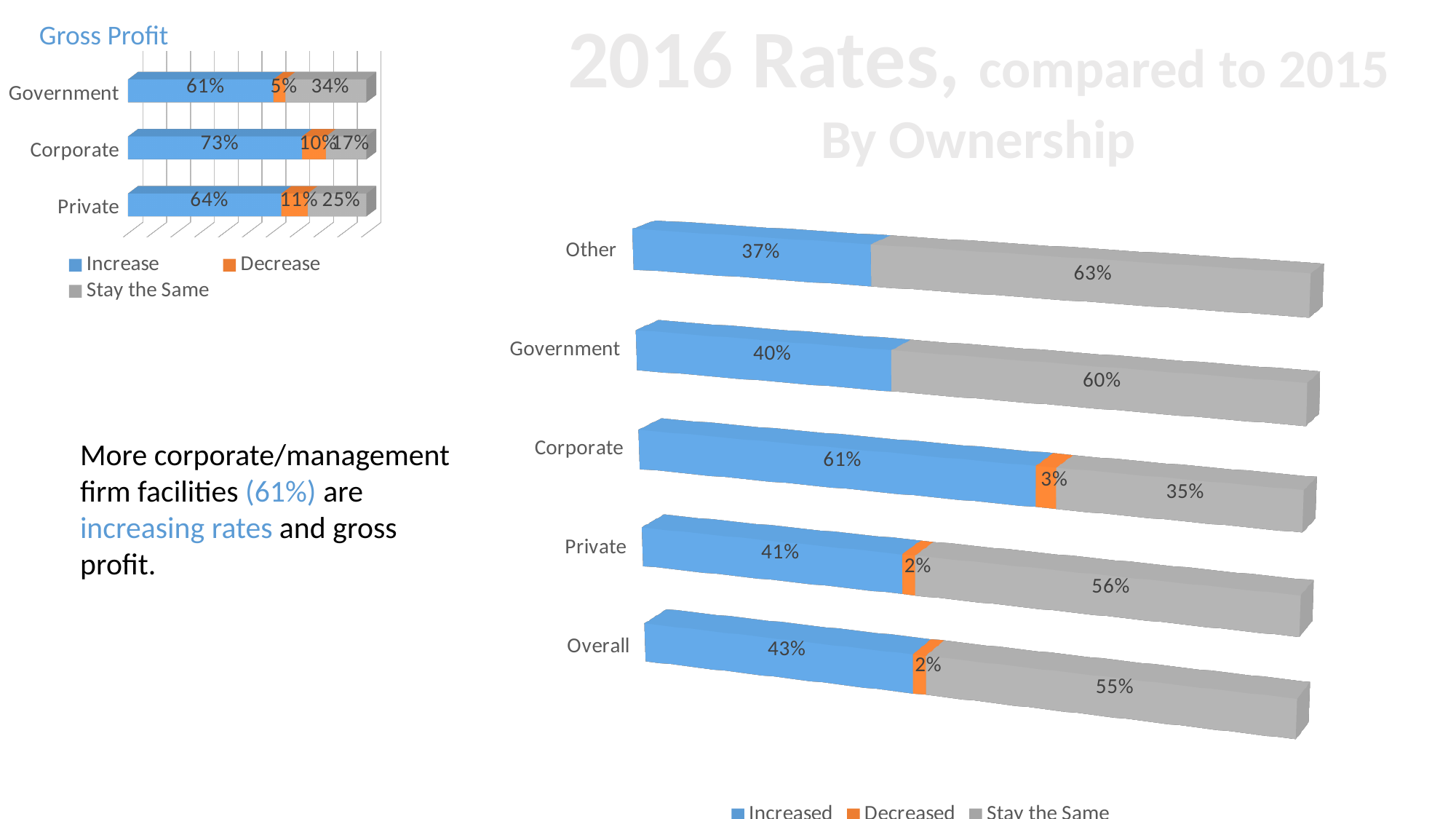
In the Gross Profit chart, which category has the highest Increase percentage? Corporate In the Gross Profit chart, what percentage of Corporate facilities reported an Increase? 73% In the 2016 Rates, compared to 2015 By Ownership chart, what percentage of Corporate facilities Increased rates? 61% In the 2016 Rates, compared to 2015 By Ownership chart, what is the difference between the Stay the Same values for Government and Corporate? 25% In the Gross Profit chart, what is the difference between the Stay the Same values for Government and Private? 9% In the Gross Profit chart, what is the Decrease value for Government? 5% In the Gross Profit chart, how many series does the legend list? 3 In the 2016 Rates, compared to 2015 By Ownership chart, which category has the lowest Increased percentage? Other In the 2016 Rates, compared to 2015 By Ownership chart, is the Increased value larger for Government or Private? Private What type of chart is the 2016 Rates, compared to 2015 By Ownership chart? Stacked bar chart In the 2016 Rates, compared to 2015 By Ownership chart, what is the Stay the Same value for Other? 63% In the 2016 Rates, compared to 2015 By Ownership chart, how many ownership categories are shown? 5